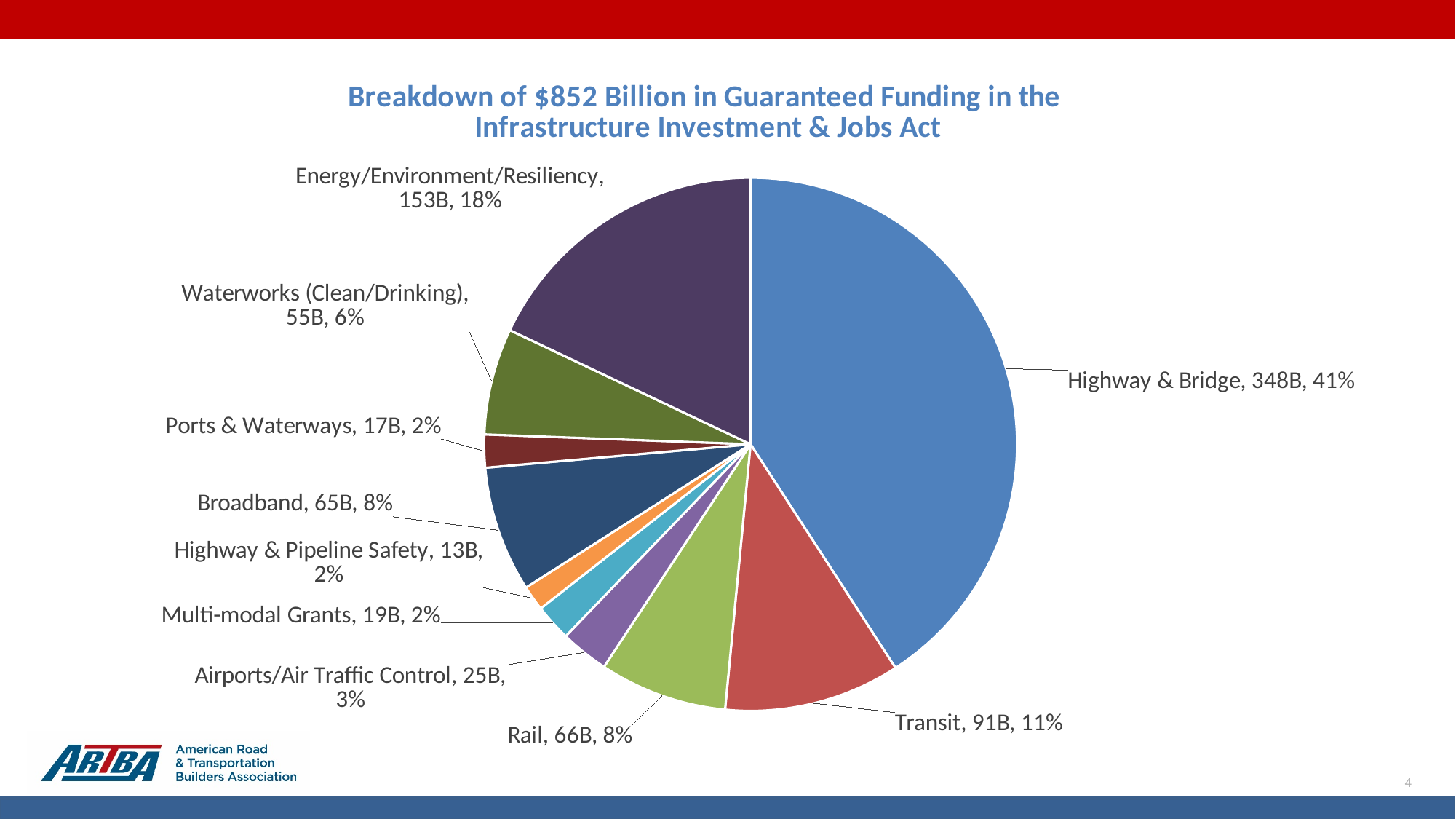
What is the value for Highway & Bridge? 348B What is the value for Broadband? 65B How many slices does the pie chart have? 10 Which category has the largest slice of the pie? Highway & Bridge What kind of chart is shown on the slide? pie chart What is the difference between the values for Highway & Bridge and Transit? 257B What share of the pie does Waterworks (Clean/Drinking) represent? 6% What is the title of the chart? Breakdown of $852 Billion in Guaranteed Funding in the Infrastructure Investment & Jobs Act Which is larger, the value for Rail or the value for Waterworks (Clean/Drinking)? Rail What is the value for Energy/Environment/Resiliency? 153B Which category has the smallest slice of the pie? Highway & Pipeline Safety What share of the pie does Transit represent? 11%